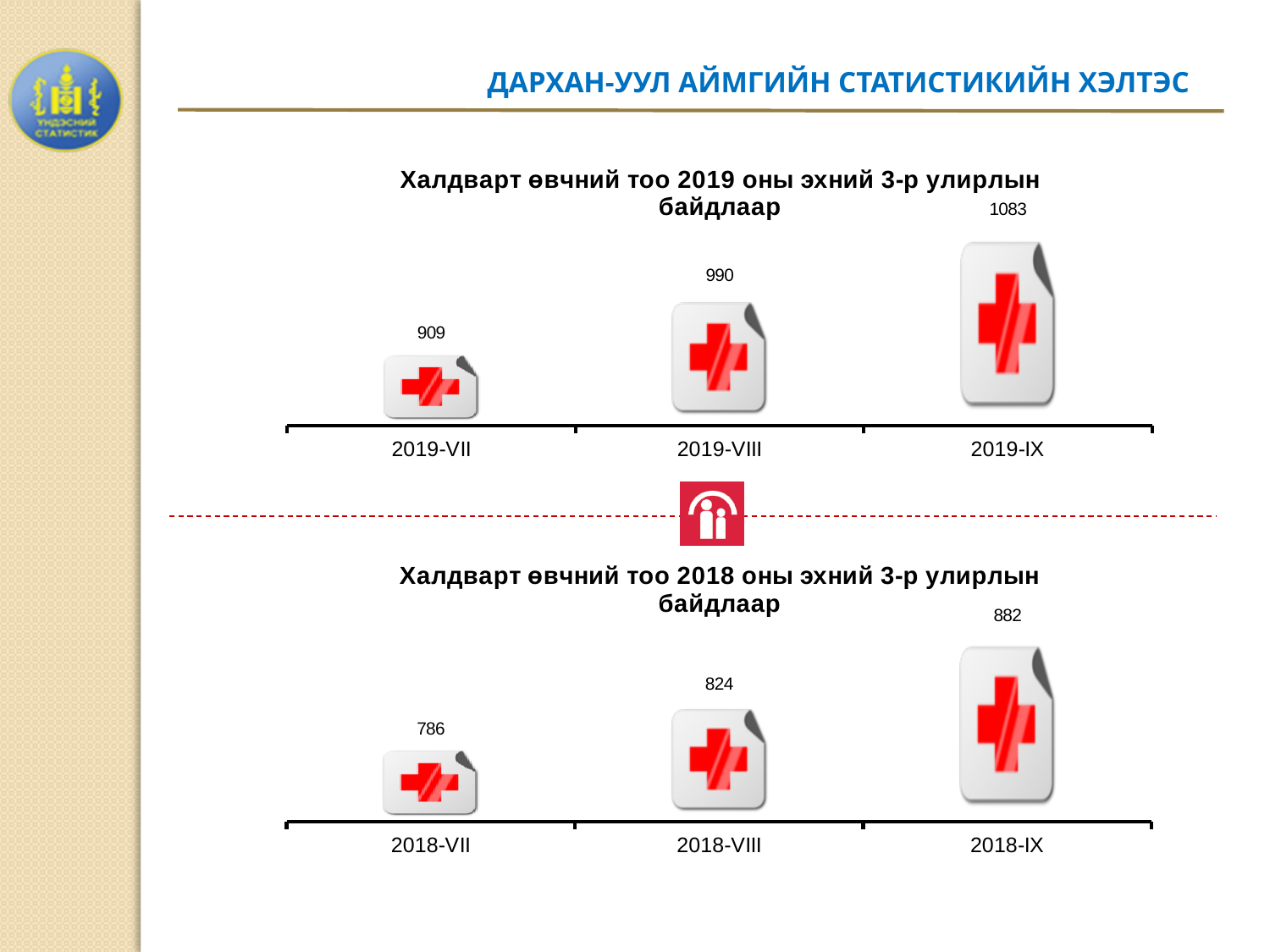
In the top chart (2019), what is the difference between the values for 2019-IX and 2019-VII? 174 In the bottom chart (2018), what is the value for 2018-IX? 882 In the bottom chart (2018), which month has the lowest value? 2018-VII Do the values in the top chart (2019) rise or fall from 2019-VII to 2019-IX? rise In the bottom chart (2018), what is the value for 2018-VII? 786 How many categories are shown on the x axis of the bottom chart (2018)? 3 In the top chart (2019), what is the value for 2019-VIII? 990 What kind of chart is the top chart (2019)? bar chart Which is larger: the value for 2019-VII in the top chart or the value for 2018-IX in the bottom chart? 2019-VII In the bottom chart (2018), what is the difference between the values for 2018-VIII and 2018-VII? 38 In the top chart (2019), what is the value for 2019-IX? 1083 In the top chart (2019), which month has the highest value? 2019-IX